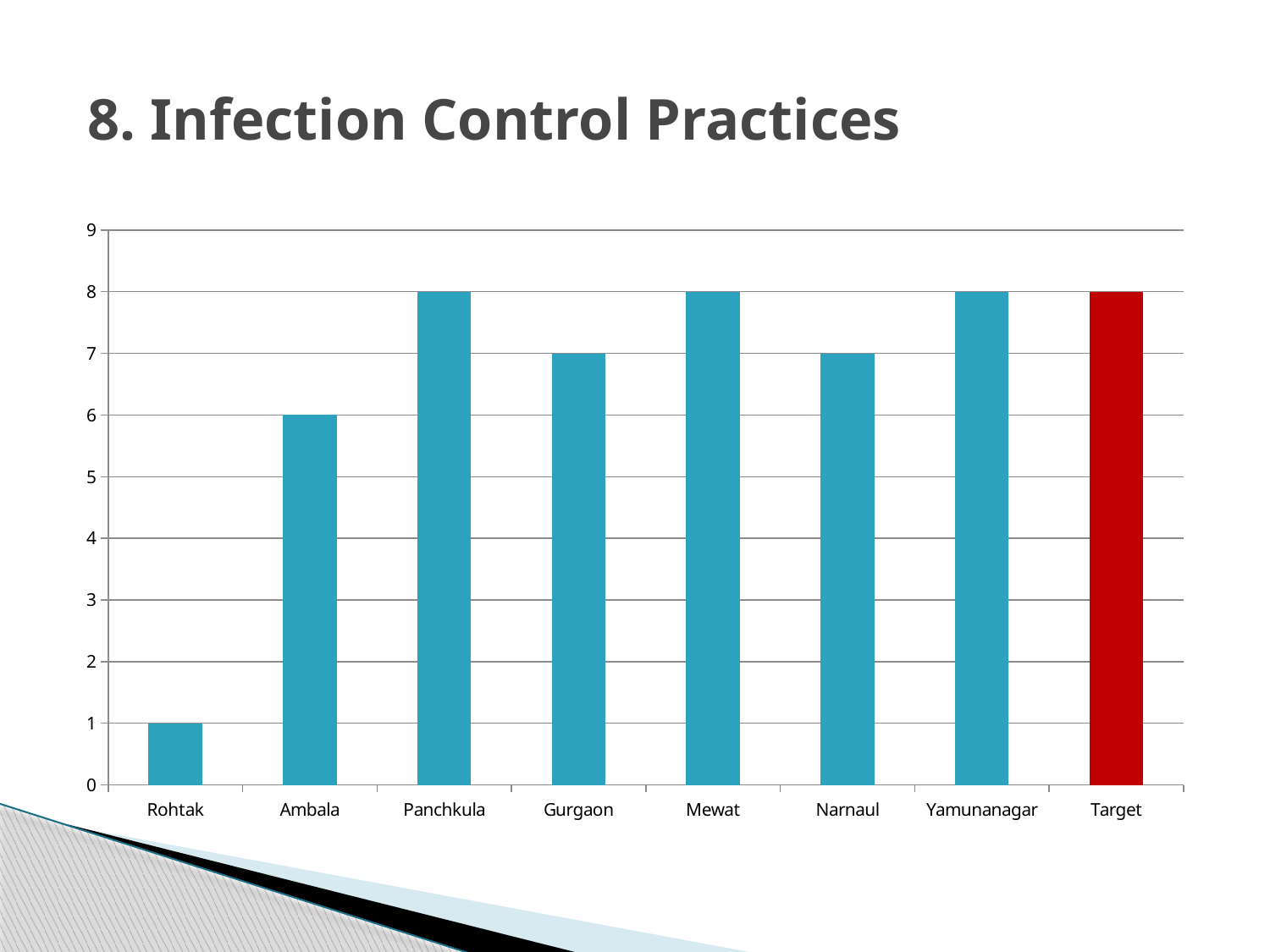
Is the value for Rohtak greater or less than 3? less What is the value of the Target bar? 8 How many bars are shown in the chart? 8 What is the difference between the Target value and the Ambala value? 2 What colour is the Target bar? red What kind of chart is shown on the slide? bar chart What is the value for Rohtak? 1 Which category has the lowest value? Rohtak What is the value for Gurgaon? 7 Which is larger, the value for Ambala or the value for Narnaul? Narnaul What is the value for Ambala? 6 What is the difference between the Ambala value and the Rohtak value? 5